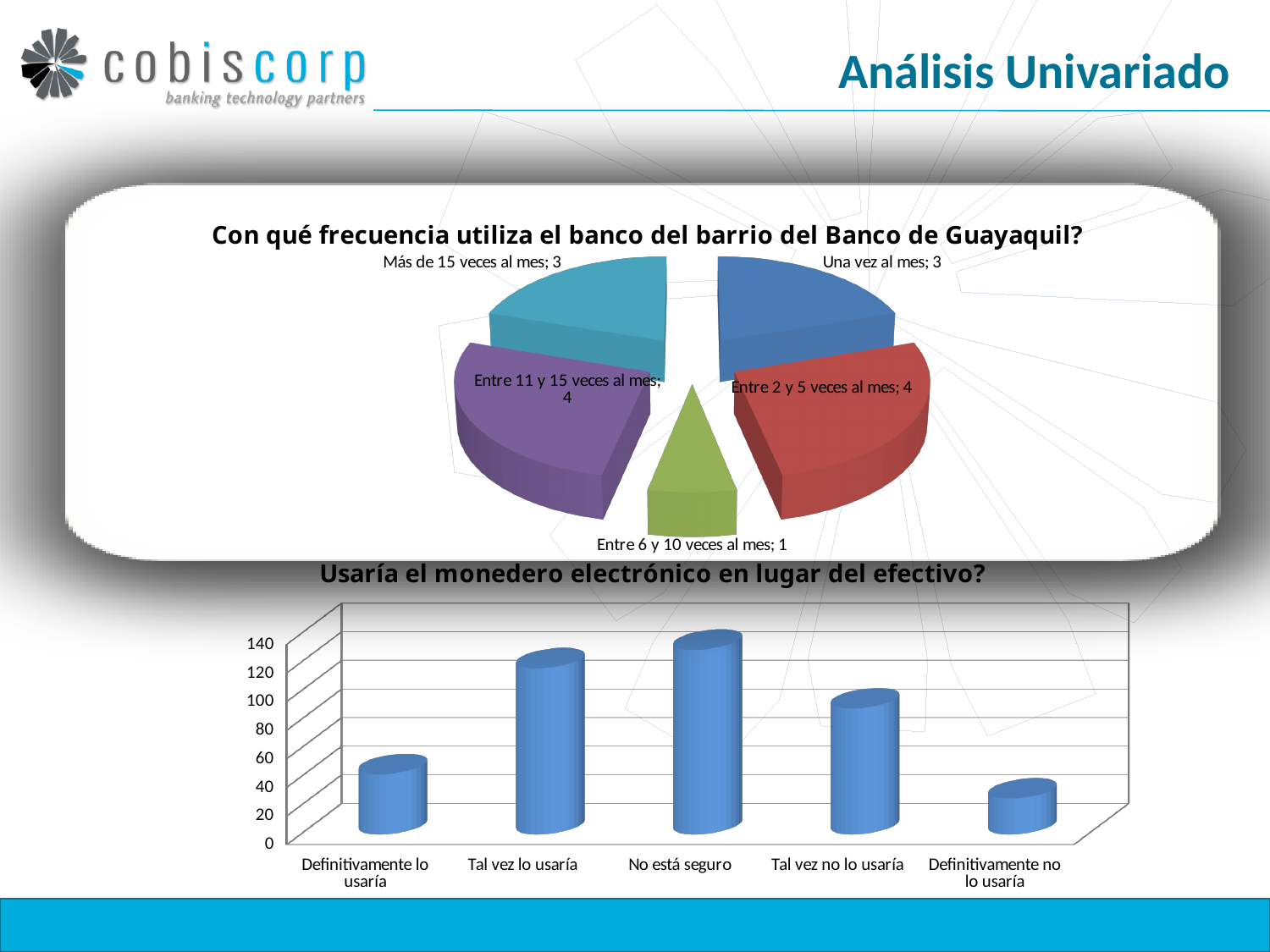
In the pie chart 'Con qué frecuencia utiliza el banco del barrio del Banco de Guayaquil?', what is the difference between 'Entre 11 y 15 veces al mes' and 'Entre 6 y 10 veces al mes'? 3 In the bar chart 'Usaría el monedero electrónico en lugar del efectivo?', is the value for 'Tal vez lo usaría' greater or less than 100? greater In the pie chart 'Con qué frecuencia utiliza el banco del barrio del Banco de Guayaquil?', how many slices are there? 5 In the bar chart 'Usaría el monedero electrónico en lugar del efectivo?', which category has the highest value? No está seguro What kind of chart is 'Usaría el monedero electrónico en lugar del efectivo?'? Bar chart In the bar chart 'Usaría el monedero electrónico en lugar del efectivo?', which is larger: 'Tal vez lo usaría' or 'Definitivamente lo usaría'? Tal vez lo usaría In the pie chart 'Con qué frecuencia utiliza el banco del barrio del Banco de Guayaquil?', what is the value for 'Una vez al mes'? 3 In the pie chart 'Con qué frecuencia utiliza el banco del barrio del Banco de Guayaquil?', which category has the smallest value? Entre 6 y 10 veces al mes In the bar chart 'Usaría el monedero electrónico en lugar del efectivo?', which category has the lowest value? Definitivamente no lo usaría What kind of chart is the top chart on the slide? Pie chart In the pie chart 'Con qué frecuencia utiliza el banco del barrio del Banco de Guayaquil?', what is the value for 'Entre 2 y 5 veces al mes'? 4 In the bar chart 'Usaría el monedero electrónico en lugar del efectivo?', is the value for 'Definitivamente no lo usaría' greater or less than 60? less